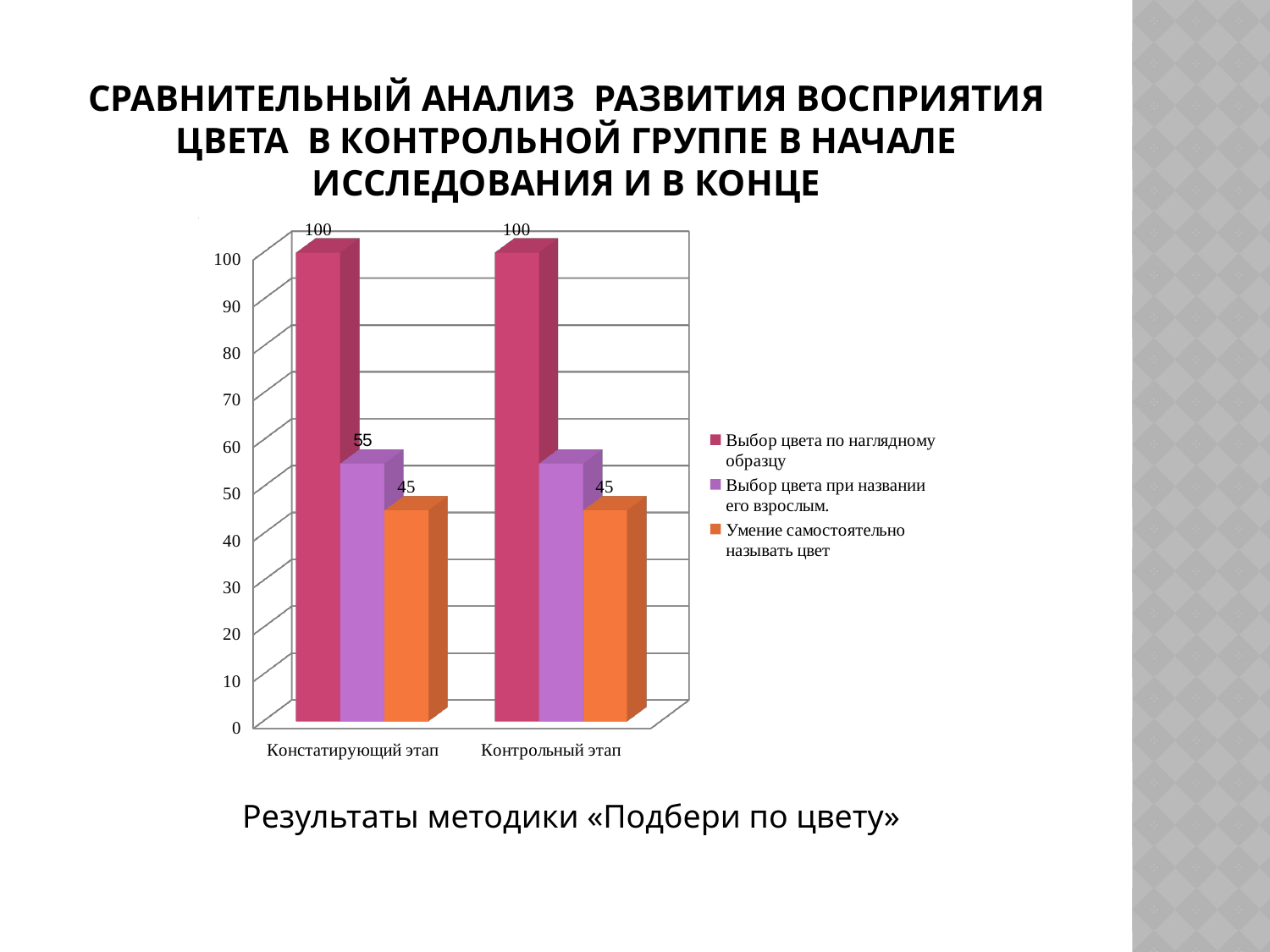
How many categories are shown on the x axis? 2 What is the difference between "Выбор цвета при названии его взрослым." and "Умение самостоятельно называть цвет" for "Констатирующий этап"? 10 What kind of chart is shown on the slide? bar chart What is the value of "Выбор цвета по наглядному образцу" for "Контрольный этап"? 100 What is the value of "Выбор цвета при названии его взрослым." for "Констатирующий этап"? 55 What is the difference between "Выбор цвета по наглядному образцу" and "Умение самостоятельно называть цвет" for "Констатирующий этап"? 55 Which series has the highest value for "Констатирующий этап"? Выбор цвета по наглядному образцу What is the value of "Выбор цвета по наглядному образцу" for "Констатирующий этап"? 100 What is the value of "Умение самостоятельно называть цвет" for "Контрольный этап"? 45 Is the value of "Выбор цвета при названии его взрослым." for "Контрольный этап" greater or less than 40? greater Which series has the lowest value for "Контрольный этап"? Умение самостоятельно называть цвет How many series does the legend list? 3